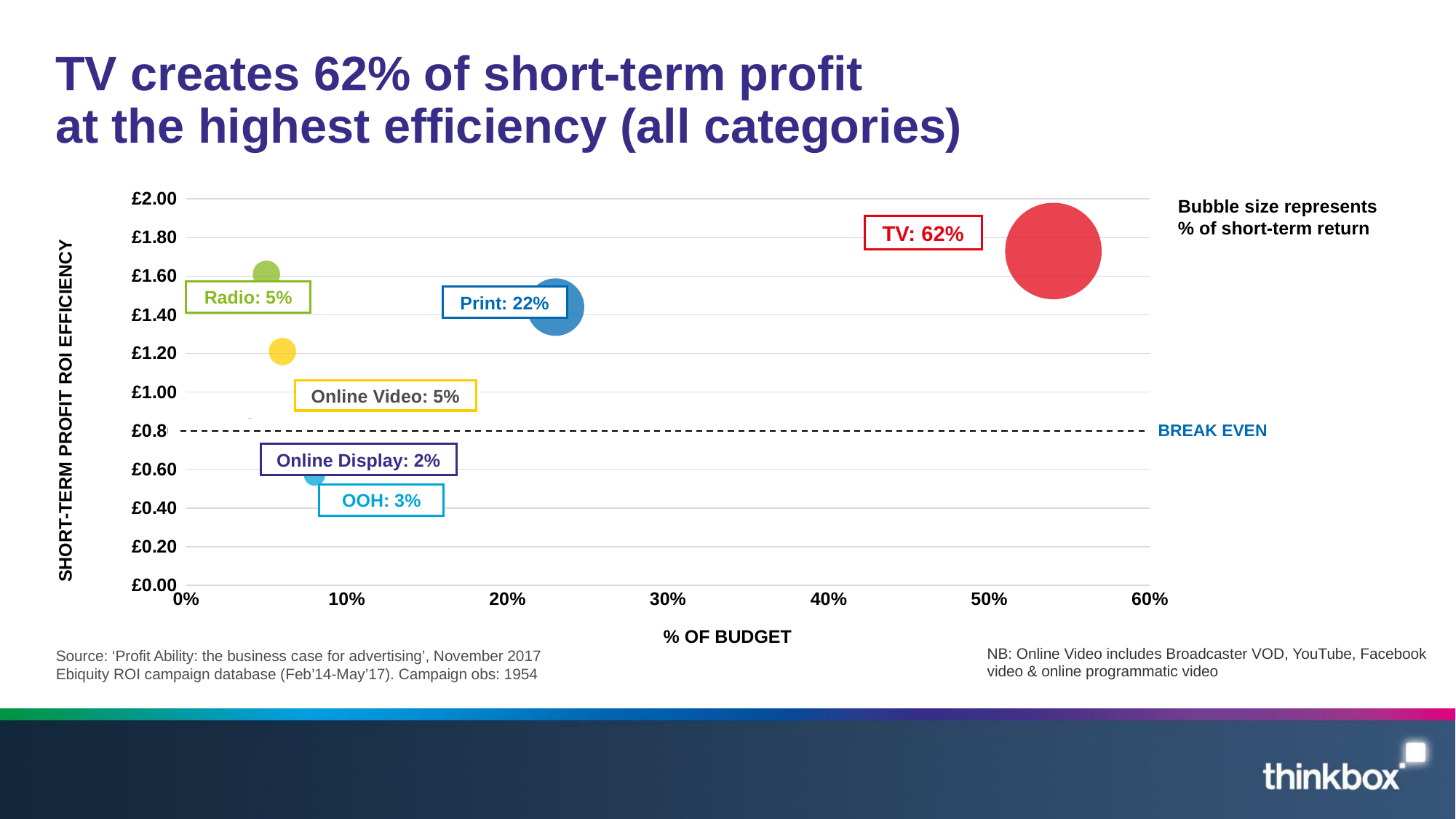
What is the difference between the short-term return shares of TV and Print? 40% What percentage of short-term return is labelled for Online Display? 2% Which medium has the largest share of short-term return? TV What kind of chart is shown on the slide? Bubble chart Is the short-term profit ROI efficiency for OOH greater or less than £0.80? less What percentage of short-term return is labelled for OOH? 3% Which has a larger share of short-term return, Print or Radio? Print What percentage of short-term return does the TV bubble represent? 62% What percentage of short-term return is labelled for Print? 22% Which medium has the smallest share of short-term return? Online Display How many media bubbles are plotted on the chart? 6 Is the short-term profit ROI efficiency for TV greater or less than £1.60? greater